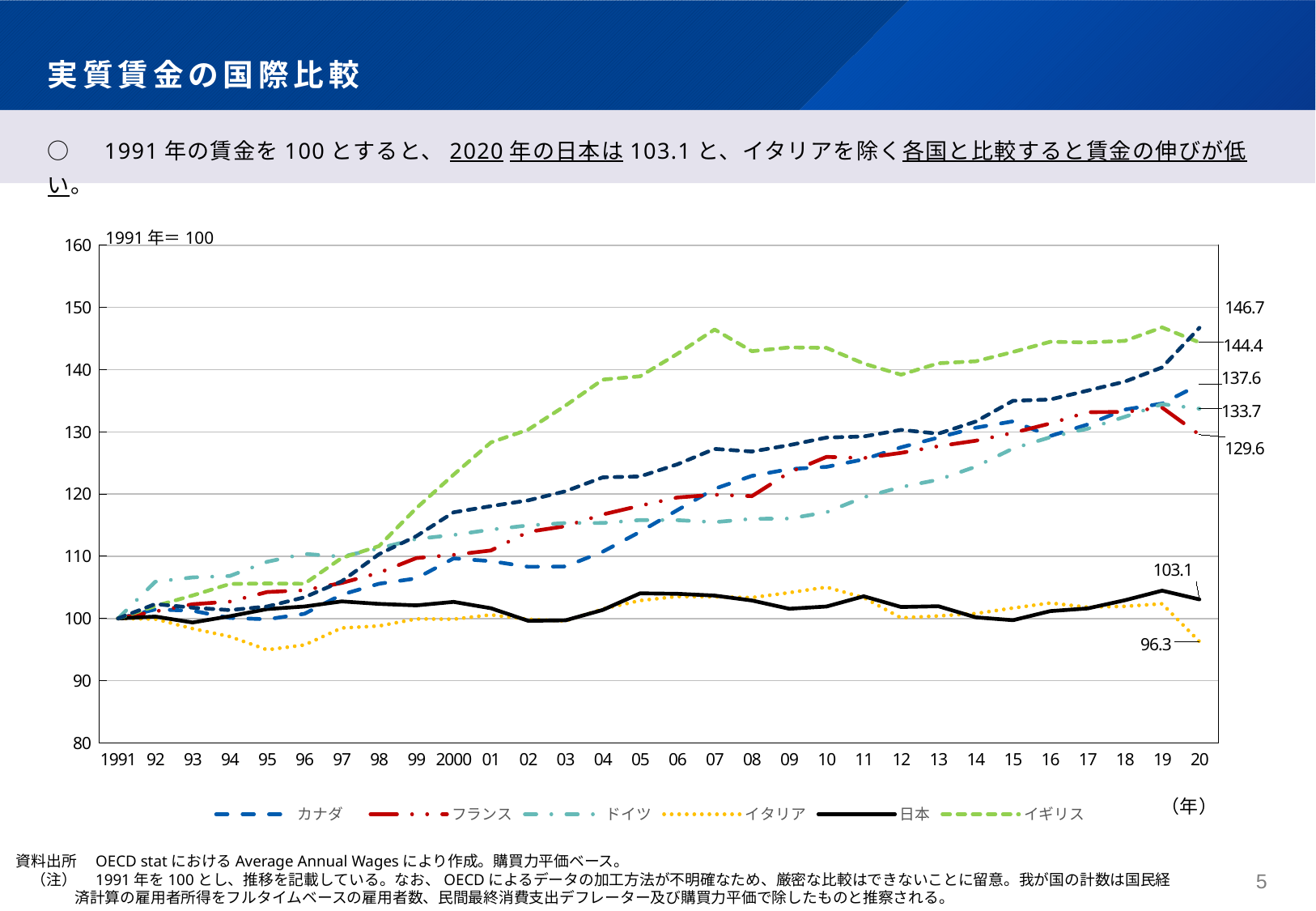
How many series does the legend list? 6 What is the value for イギリス (UK) in 2020? 144.4 Which is larger in 2020, the value for 日本 or the value for イタリア? 日本 Is the value for 日本 in 2020 greater or less than 110? less What is the difference between the 2020 values for 日本 (103.1) and イタリア (96.3)? 6.8 What is the value for フランス (France) in 2020? 129.6 Which country has the lowest value in 2020? イタリア Does the イギリス (UK) line generally rise or fall from 1991 to 2020? Rise What is the value for ドイツ (Germany) in 2020? 133.7 What is the value for イタリア (Italy) in 2020? 96.3 What is the value for 日本 (Japan) in 2020? 103.1 What kind of chart is shown on the slide? Line chart